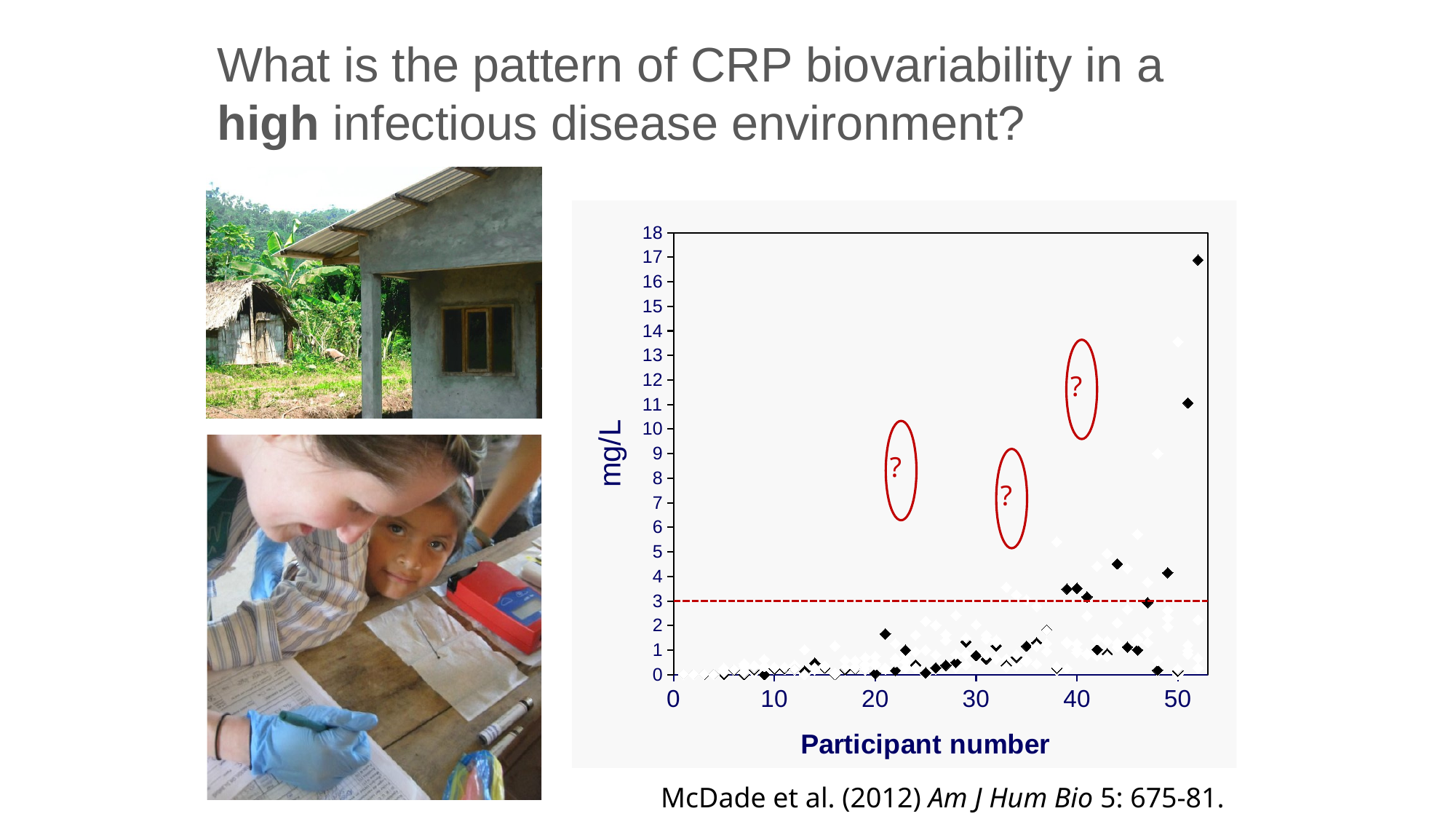
At what y-axis value is the dashed red horizontal line drawn? 3 Do the plotted values generally rise or fall as the participant number increases along the x axis? rise What is the label of the x axis of the chart? Participant number What is the label of the y axis of the chart? mg/L What is the highest tick value shown on the x axis? 50 What is the highest tick value shown on the y axis? 18 Are the plotted values for participants below 10 greater or less than 3 mg/L? less What kind of chart is shown on the slide? scatter chart How many red ellipses containing a question mark are drawn on the chart? 3 Is the highest plotted point on the chart greater or less than 15 mg/L? greater